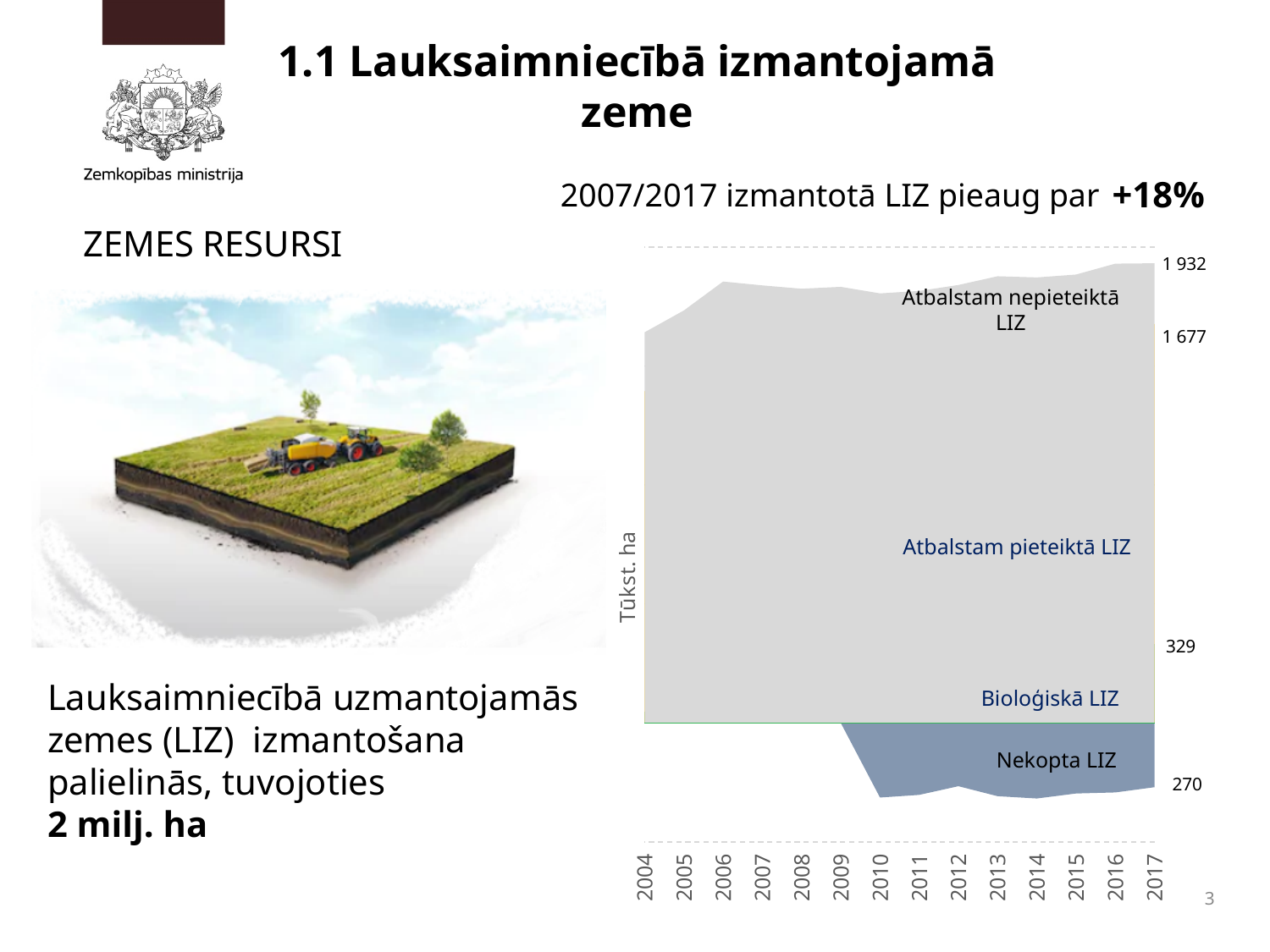
How many labelled series (areas) does the chart show? 4 What is the last year shown on the x axis of the chart? 2017 By what percentage does the slide say the used LIZ grew between 2007 and 2017? +18% What value label is printed beside the Nekopta LIZ area on the right side of the chart? 270 Which series is shown as the blue area at the bottom of the chart? Nekopta LIZ How many years are shown on the x axis of the chart? 14 Does the top edge of the stacked area (total LIZ) rise or fall from 2004 to 2017? rise What is the first year shown on the x axis of the chart? 2004 What kind of chart is shown on the right side of the slide? area chart What is the label of the vertical axis of the chart? Tūkst. ha What is the topmost value label printed on the right side of the chart? 1 932